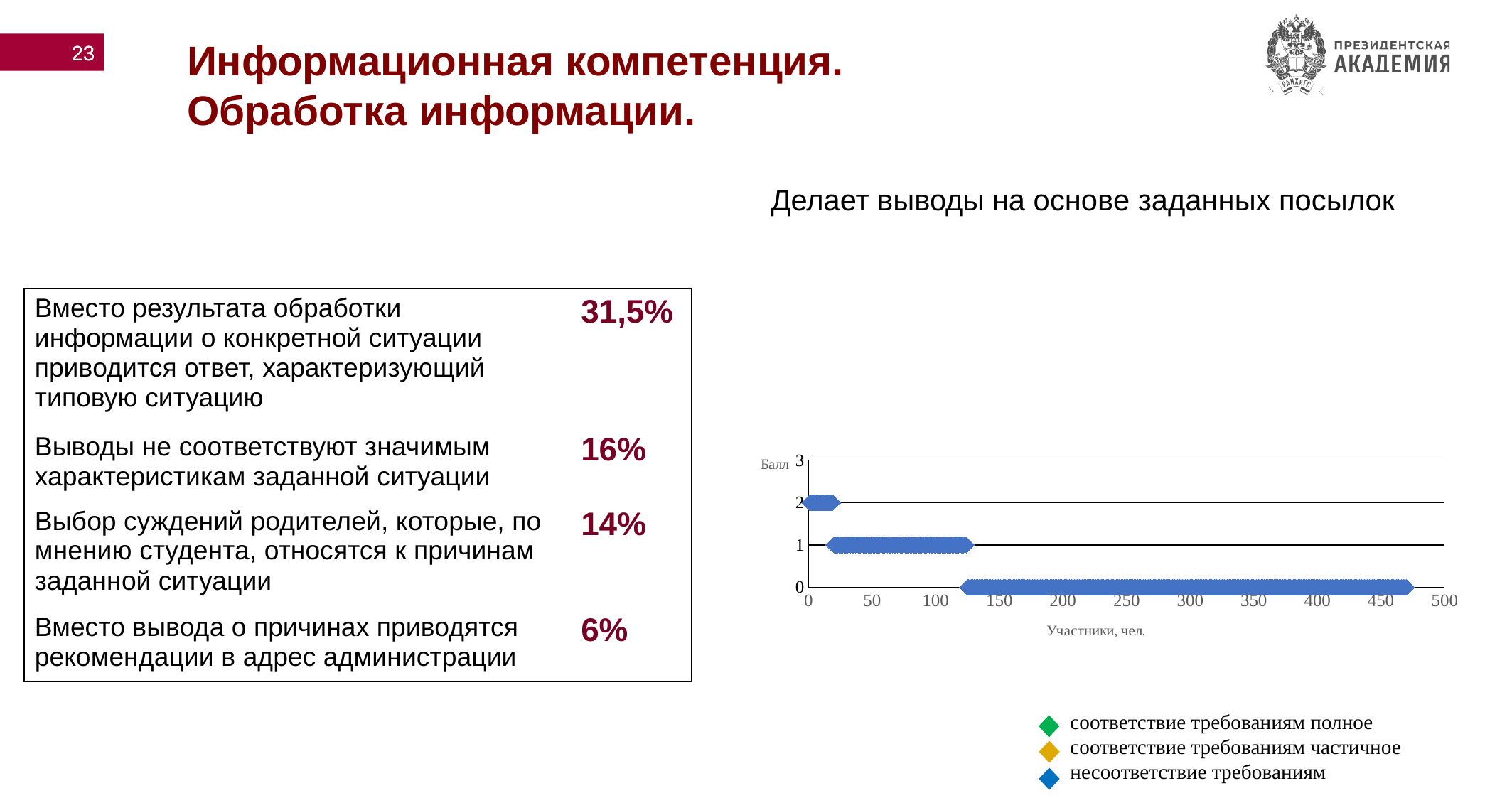
Which score level (Балл) has markers spanning the widest range of participants? 0 Is the largest participant value for score 1 greater or less than 100? greater Is the largest participant value for score 1 greater or less than 200? less Is the largest participant value for score 2 greater or less than 50? less What is the title of the chart on the slide? Делает выводы на основе заданных посылок Which score level (Балл) has markers spanning the narrowest range of participants? 2 What is the highest tick value shown on the chart's horizontal axis? 500 How many entries does the chart's legend list? 3 What is the label of the chart's horizontal axis? Участники, чел. What kind of chart is shown on the slide? scatter chart What is the highest tick value shown on the chart's vertical axis (Балл)? 3